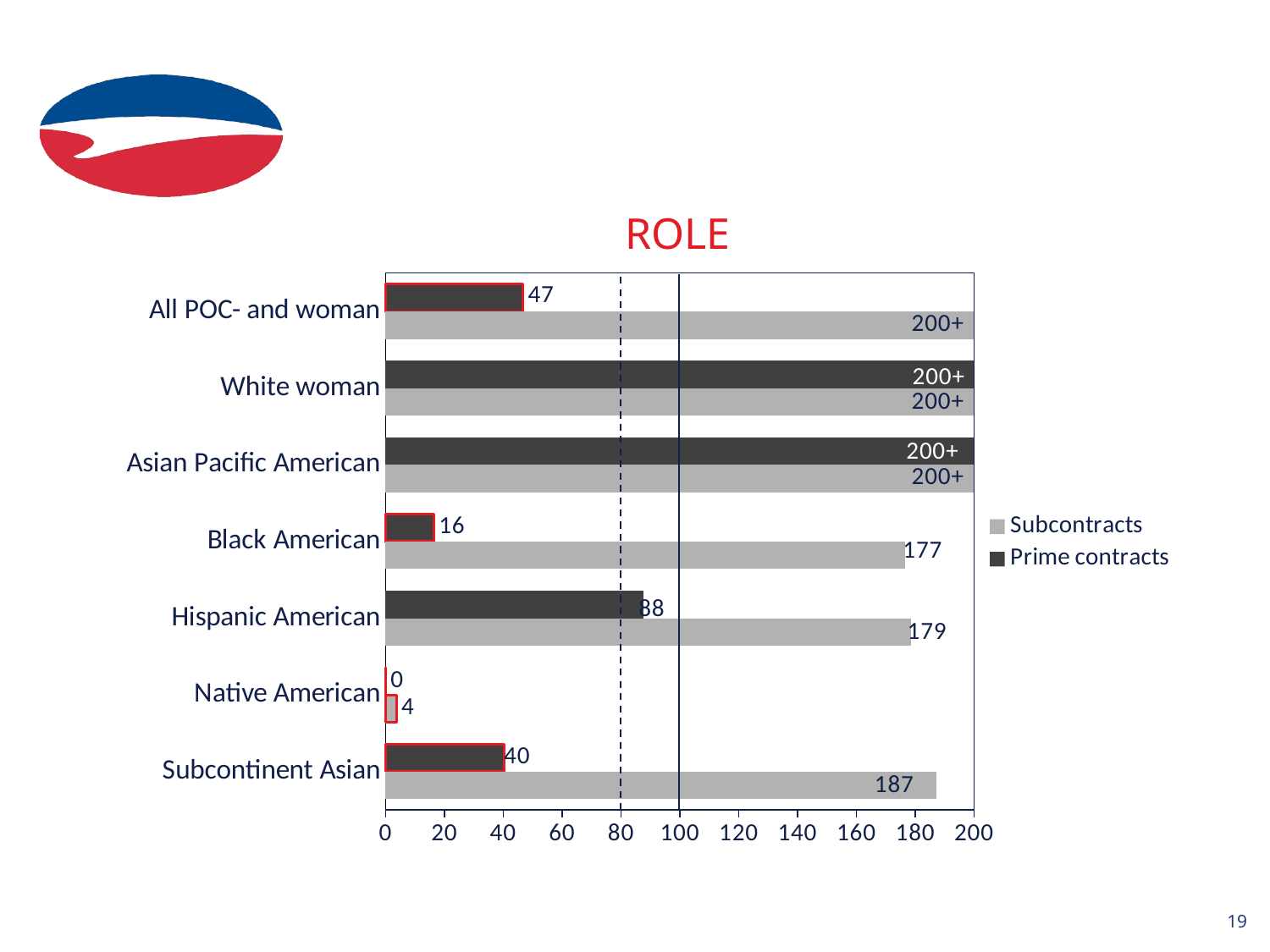
What is the Subcontracts value for Subcontinent Asian? 187 What kind of chart is shown on the slide? bar chart How many series does the legend list? 2 Which category has the lowest Subcontracts value? Native American What is the Subcontracts value for Black American? 177 What is the Subcontracts value for Hispanic American? 179 What is the Prime contracts value for Native American? 0 Is the Prime contracts value for Hispanic American greater or less than 80? greater How many categories are shown on the chart? 7 Which has the larger Prime contracts value, Black American or Subcontinent Asian? Subcontinent Asian What is the Prime contracts value for All POC- and woman? 47 How much larger is the Subcontracts value for Subcontinent Asian than for Black American? 10